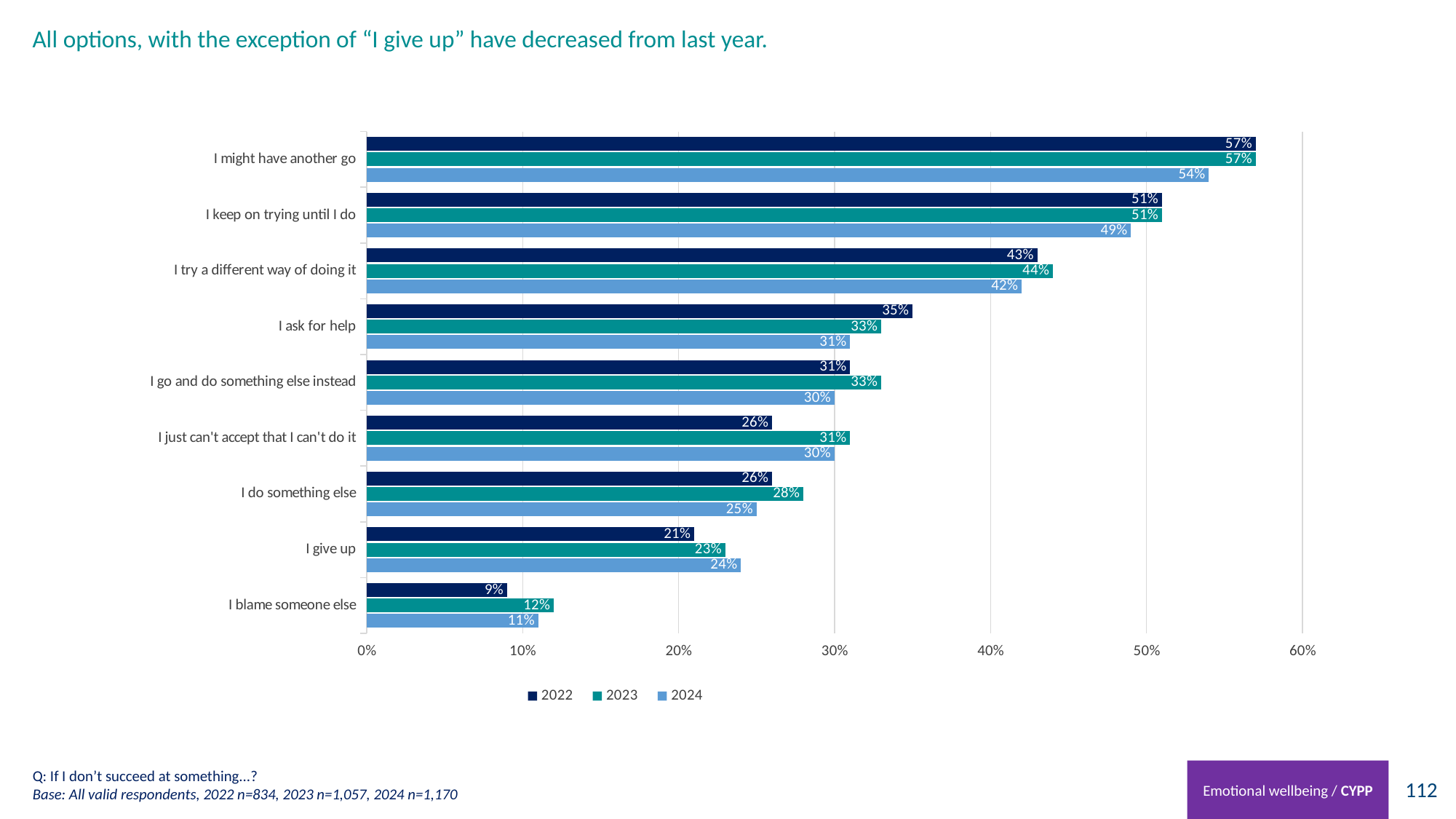
Which series is shown in the darkest colour in the legend? 2022 What is the difference between the 2022 and 2024 values for "I keep on trying until I do"? 2% What kind of chart is shown on the slide? Bar chart What is the difference between the 2023 and 2024 values for "I ask for help"? 2% What is the 2023 value for "I try a different way of doing it"? 44% How many categories are shown on the chart? 9 Which category has the highest 2022 value? I might have another go How many series does the legend list? 3 Which is larger for "I give up": the 2023 value or the 2024 value? 2024 Which category has the lowest 2024 value? I blame someone else What is the 2024 value for "I might have another go"? 54% What is the 2022 value for "I blame someone else"? 9%